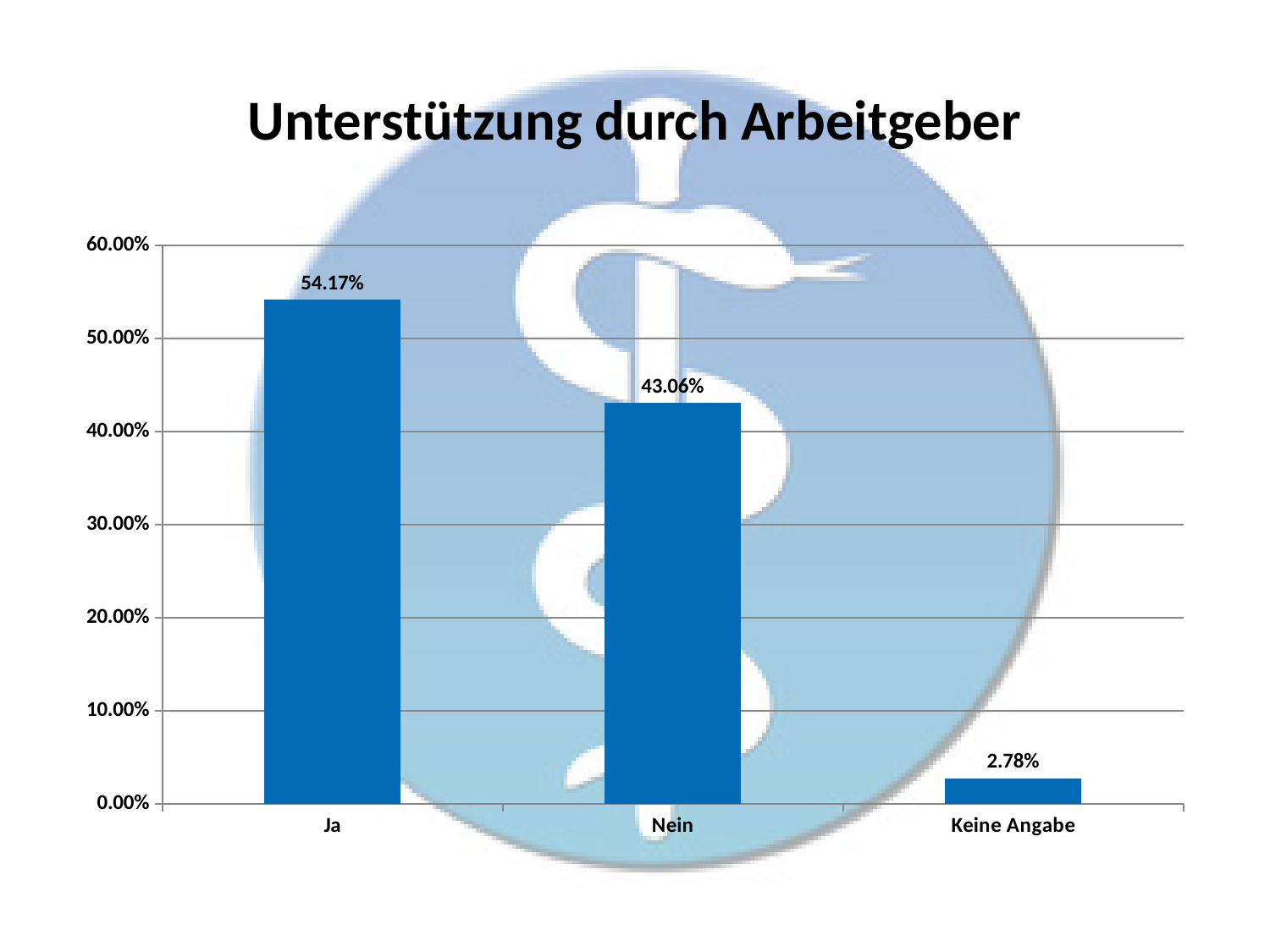
What is the difference between the values for "Nein" and "Keine Angabe"? 40.28% Which category has the lowest value? Keine Angabe What kind of chart is shown on the slide? bar chart Which is larger, the value for "Ja" or the value for "Nein"? Ja What is the value for "Ja"? 54.17% What is the difference between the values for "Ja" and "Nein"? 11.11% What is the value for "Nein"? 43.06% Which category has the highest value? Ja Is the value for "Nein" greater or less than 50.00%? less What is the value for "Keine Angabe"? 2.78% What is the title of the chart? Unterstützung durch Arbeitgeber How many categories are shown on the x axis? 3